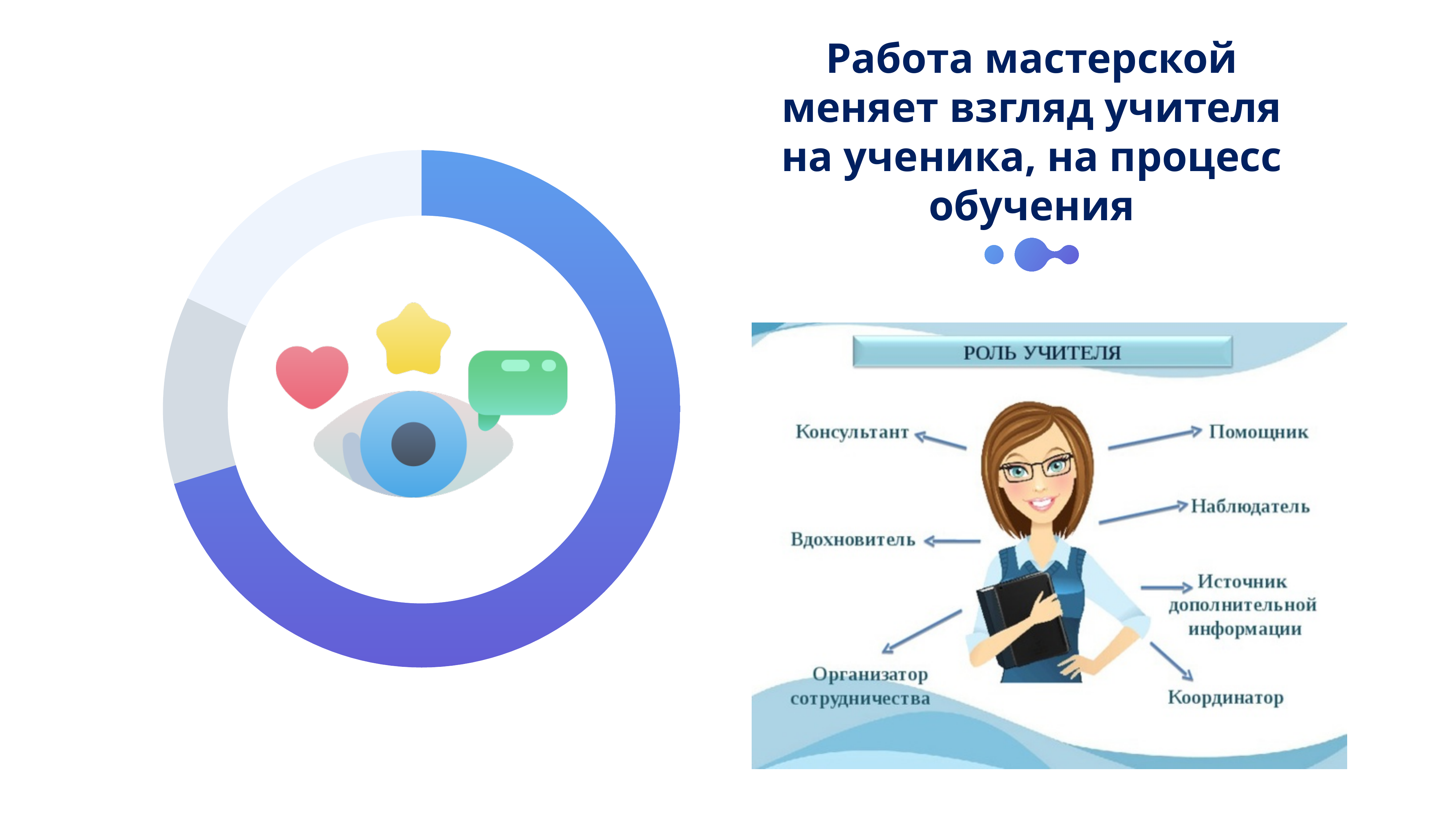
Does the donut chart on the left side of the slide display any data labels or values? No What kind of chart is shown on the left side of the slide? Donut chart Does the donut chart on the left side of the slide have a legend? No Which colour segment of the donut chart on the left side of the slide is the largest? Blue How many segments does the donut chart on the left side of the slide have? 3